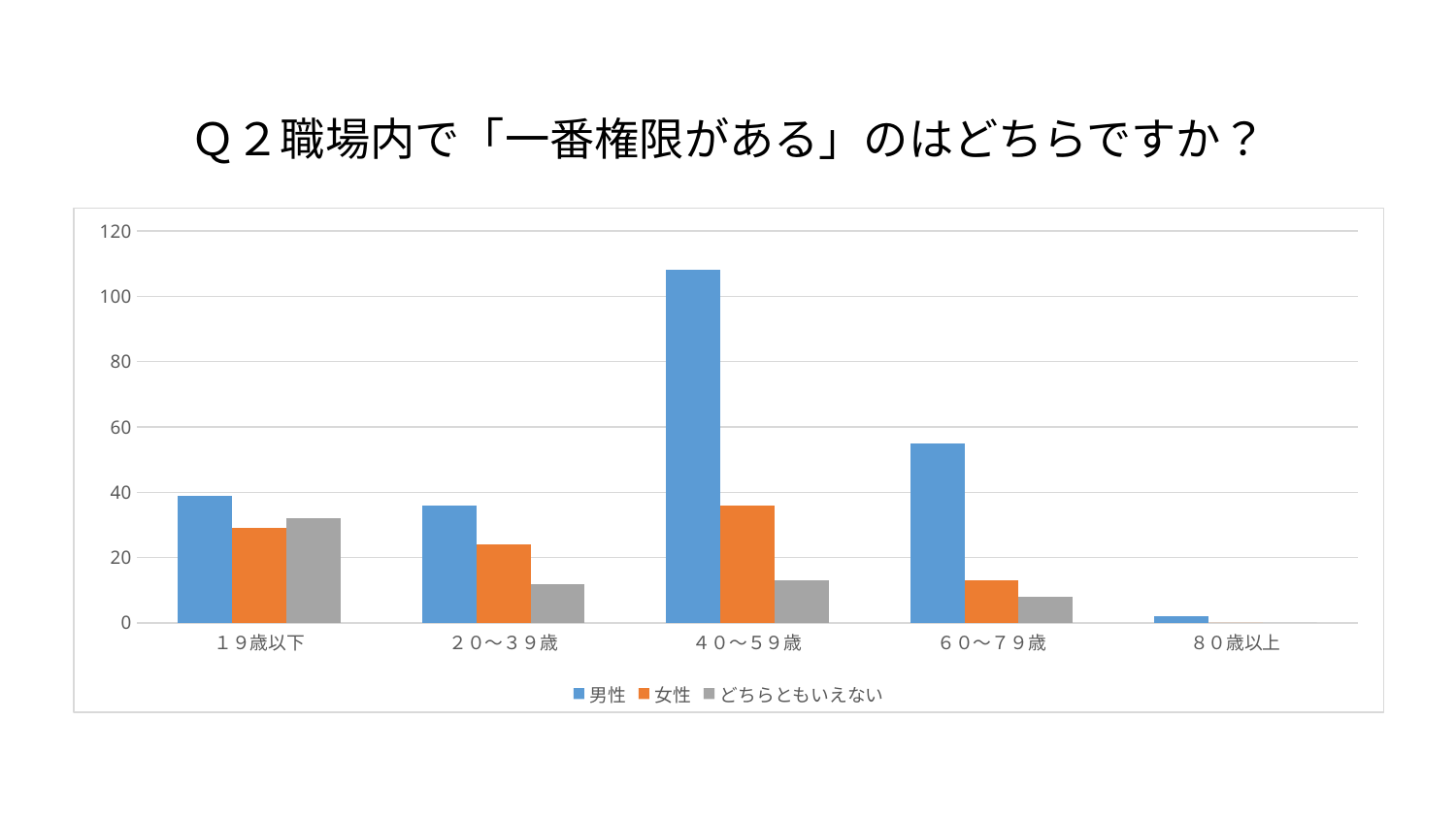
How many age-group categories are shown on the x axis? 5 In the ４０〜５９歳 group, which is larger: 女性 or どちらともいえない? 女性 What kind of chart is shown on the slide? Bar chart What is the title of the slide? Ｑ２職場内で「一番権限がある」のはどちらですか？ How many series does the legend list? 3 Is the value for 男性 in the ４０〜５９歳 group greater or less than 100? greater Is the value for 男性 in the ６０〜７９歳 group greater or less than 40? greater Which age group has the lowest value for 男性? ８０歳以上 Is the value for 女性 in the ２０〜３９歳 group greater or less than 40? less What colour represents the 男性 series? Blue Which age group has the highest value for 男性? ４０〜５９歳 In the １９歳以下 group, which is larger: 男性 or 女性? 男性